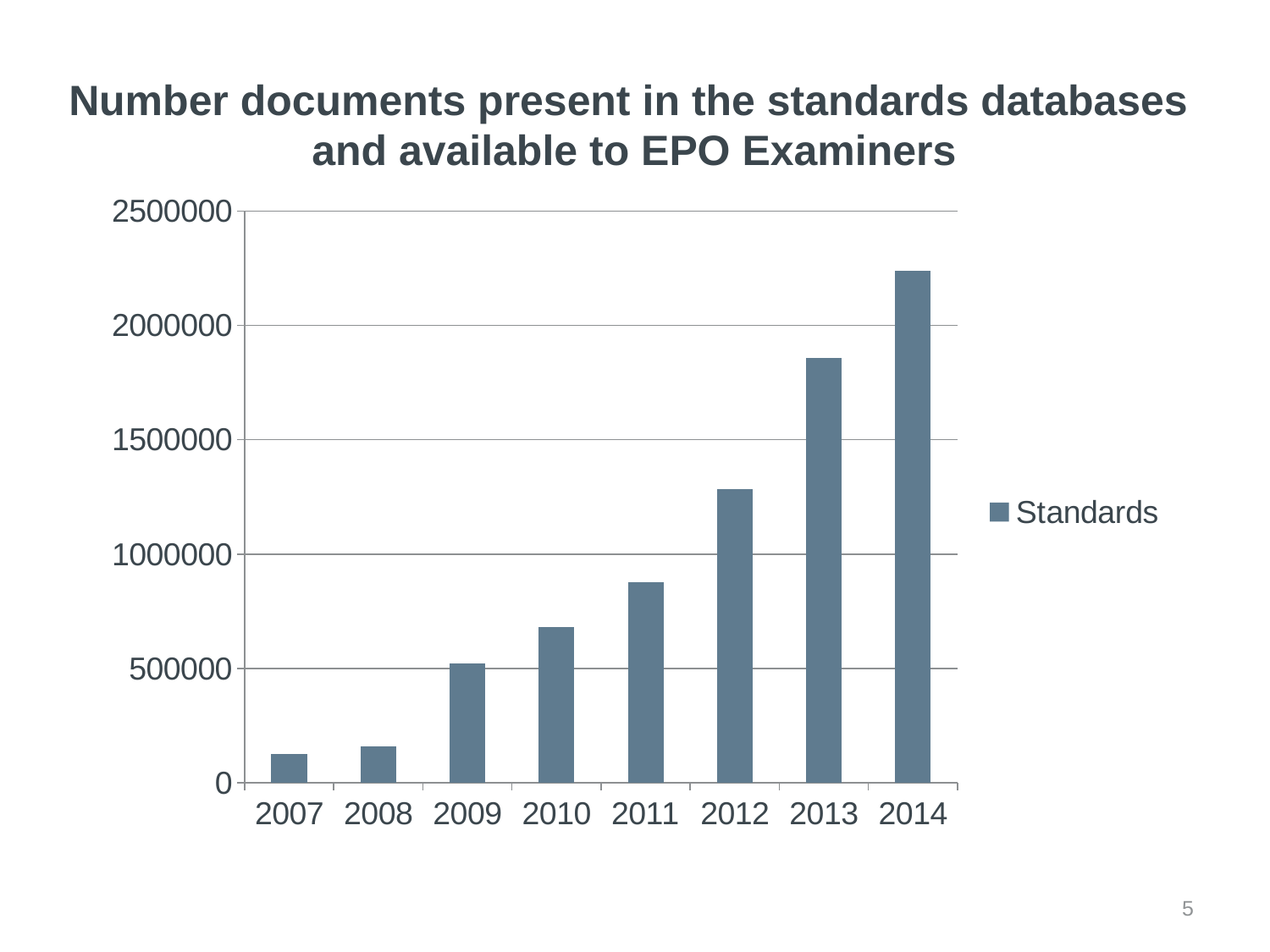
Is the value for 2012 greater or less than 1000000? greater How many years are shown on the x axis of the chart? 8 Which year has the highest number of standards documents? 2014 What is the name of the series shown in the legend? Standards Which year has the lowest number of standards documents? 2007 Do the values rise or fall from 2007 to 2014? rise Is the value for 2011 greater or less than 1000000? less How many series does the legend list? 1 Is the value for 2013 greater or less than 2000000? less Which year has the larger value, 2010 or 2012? 2012 What kind of chart is shown on the slide? bar chart